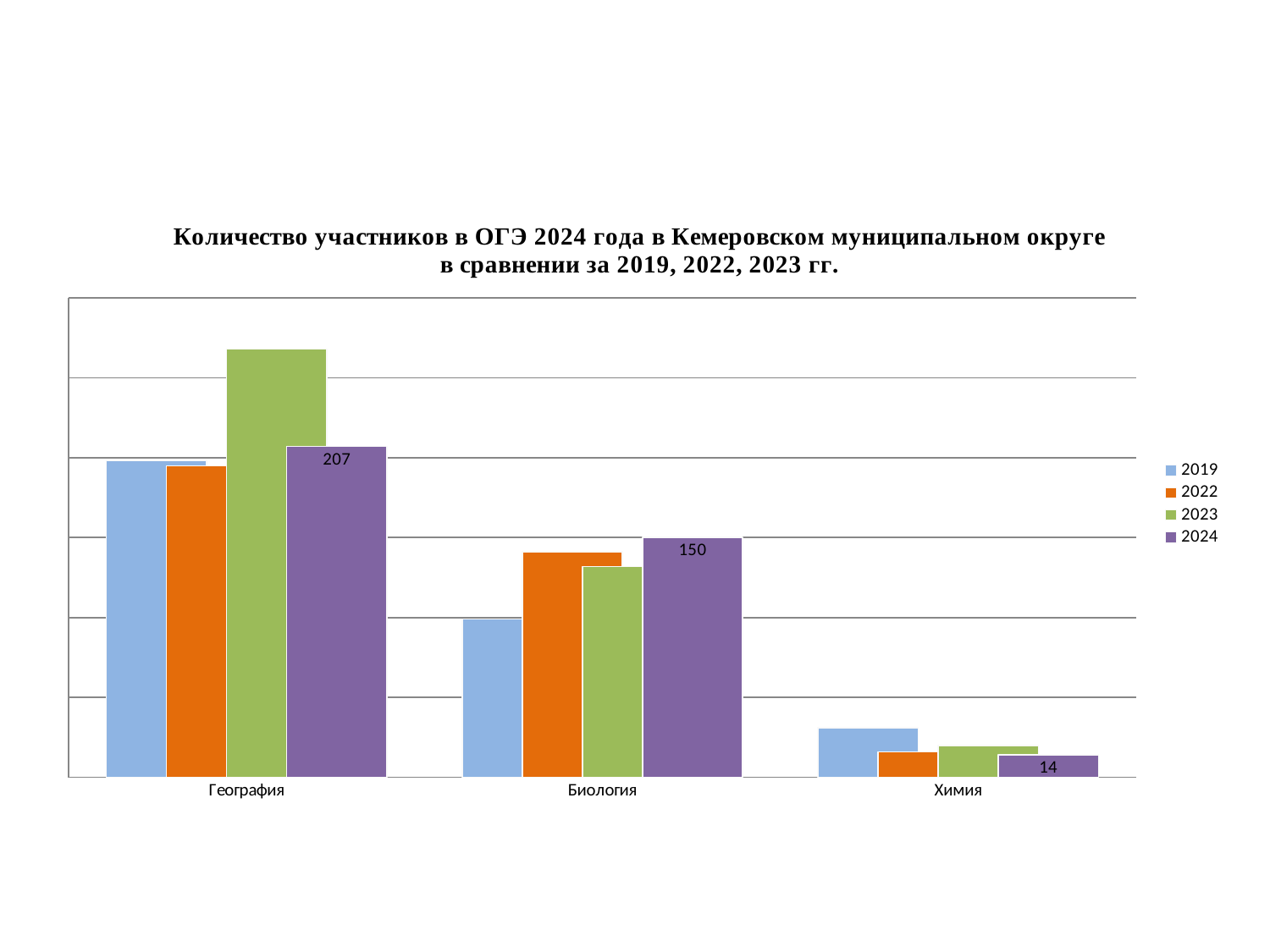
Which category has the highest value for the 2024 series? География In the География category, which is larger: the 2023 bar or the 2024 bar? 2023 How many categories are shown on the x axis? 3 What kind of chart is shown on the slide? Bar chart What is the value for 2024 in the География category? 207 In the Биология category, which is larger: the 2019 bar or the 2022 bar? 2022 What is the value for 2024 in the Биология category? 150 What is the difference between the 2024 values for География and Биология? 57 How many series does the legend list? 4 What is the difference between the 2024 values for Биология and Химия? 136 What is the value for 2024 in the Химия category? 14 Which category has the lowest value for the 2024 series? Химия